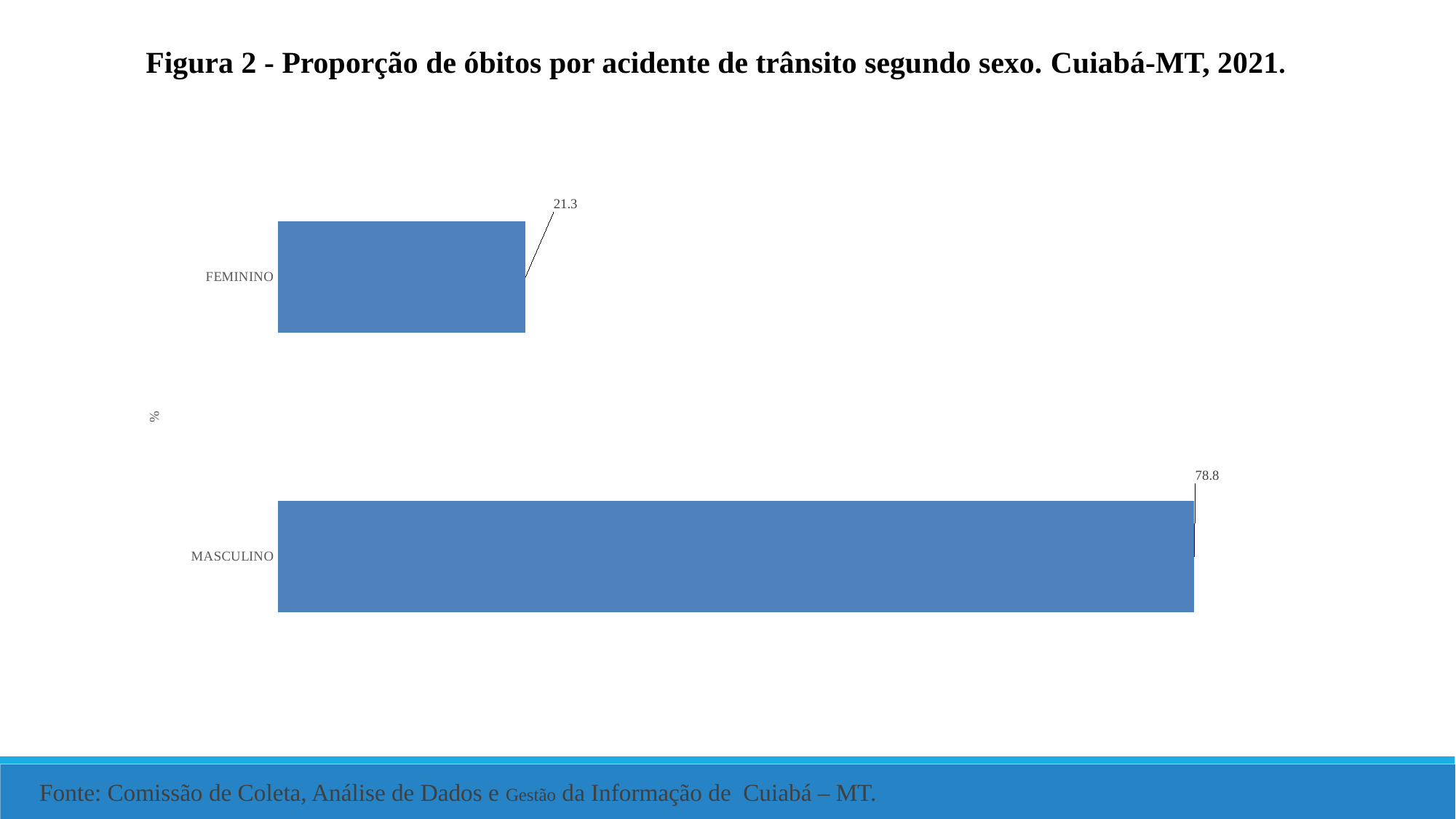
What is the value for MASCULINO? 78.8 Which category has the lowest value? FEMININO What kind of chart is shown on the slide? Bar chart What unit is indicated on the vertical axis label of the chart? % Which category has the highest value? MASCULINO How many categories are shown in the chart? 2 What is the value for FEMININO? 21.3 What is the title of the figure on the slide? Figura 2 - Proporção de óbitos por acidente de trânsito segundo sexo. Cuiabá-MT, 2021. What is the difference between the values for MASCULINO and FEMININO? 57.5 Which is larger, the value for FEMININO or the value for MASCULINO? MASCULINO